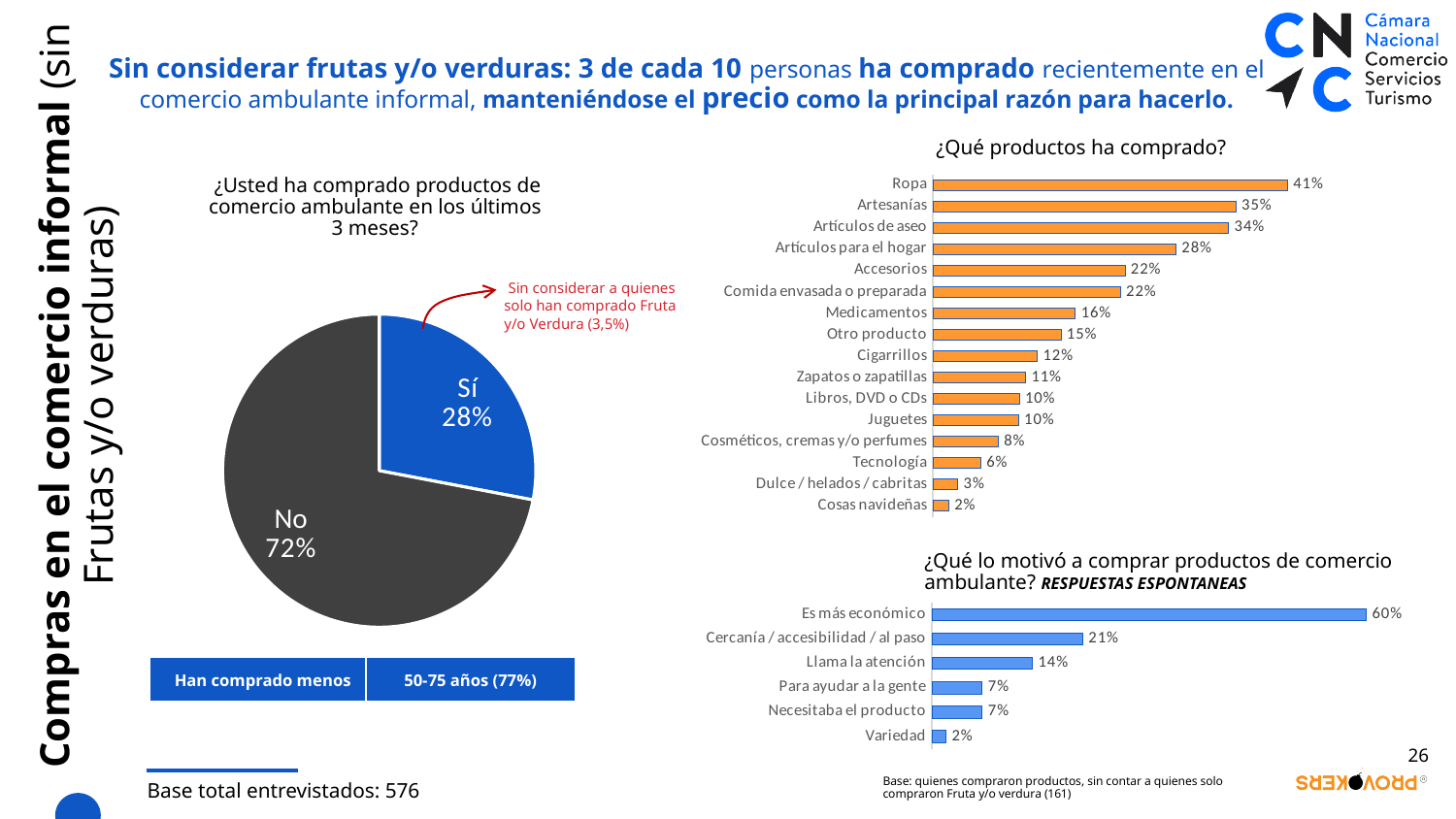
In the chart '¿Qué productos ha comprado?', what is the value for Ropa? 41% In the chart '¿Qué productos ha comprado?', which product has the lowest value? Cosas navideñas In the pie chart '¿Usted ha comprado productos de comercio ambulante en los últimos 3 meses?', what share of respondents answered 'Sí'? 28% In the chart '¿Qué lo motivó a comprar productos de comercio ambulante?', what is the difference between 'Es más económico' and 'Cercanía / accesibilidad / al paso'? 39% In the chart '¿Qué lo motivó a comprar productos de comercio ambulante?', what is the value for 'Es más económico'? 60% In the pie chart '¿Usted ha comprado productos de comercio ambulante en los últimos 3 meses?', what share of respondents answered 'No'? 72% In the chart '¿Qué productos ha comprado?', how many product categories are shown? 16 What kind of chart is '¿Qué lo motivó a comprar productos de comercio ambulante?'? Bar chart In the chart '¿Qué productos ha comprado?', what is the difference between Artesanías and Artículos de aseo? 1% In the chart '¿Qué lo motivó a comprar productos de comercio ambulante?', how many categories are shown? 6 In the chart '¿Qué productos ha comprado?', which is larger: Medicamentos or Cigarrillos? Medicamentos In the pie chart '¿Usted ha comprado productos de comercio ambulante en los últimos 3 meses?', how many slices are there? 2